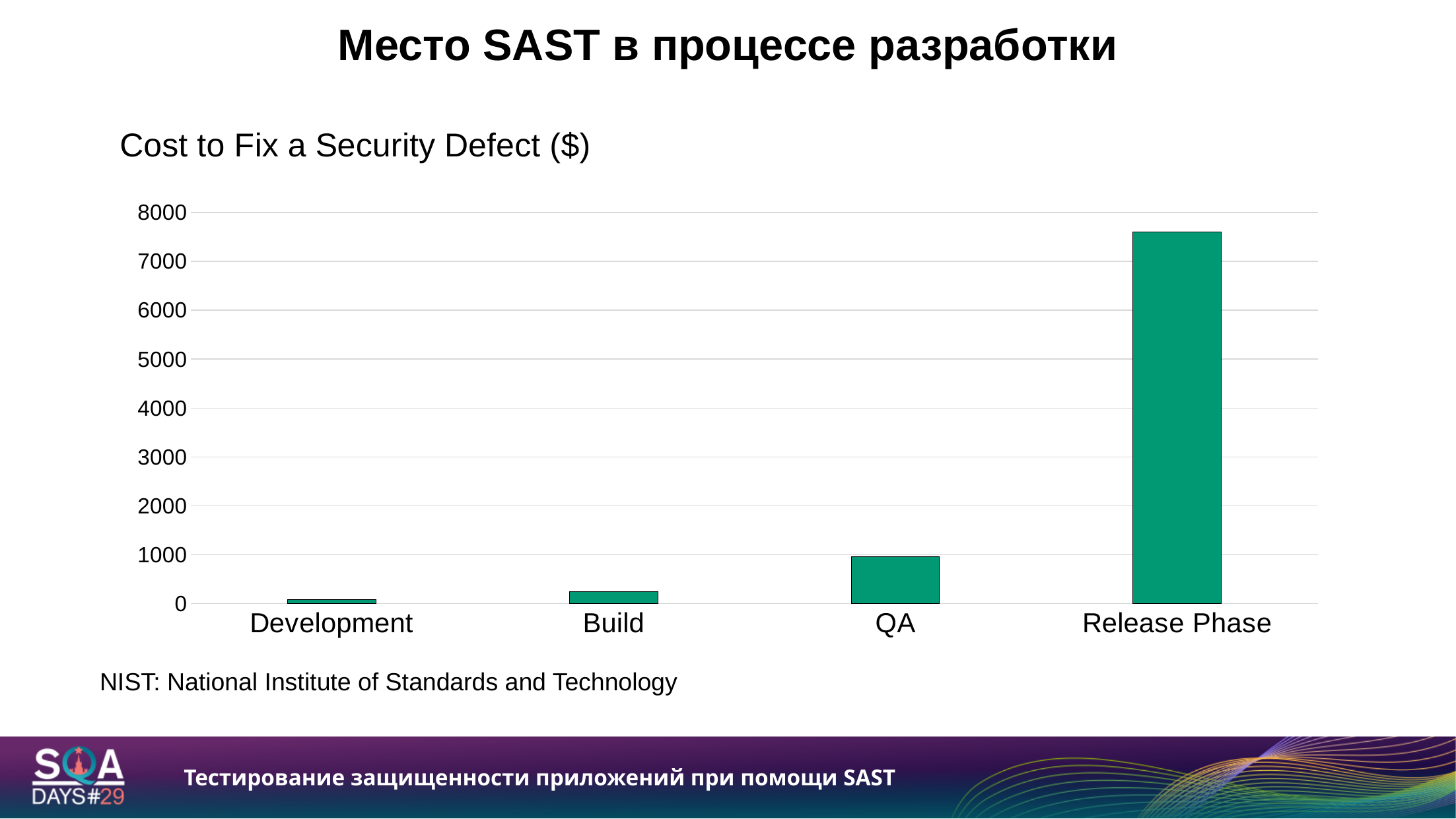
Which category has the lowest cost to fix a security defect? Development How many categories are shown on the x axis of the chart? 4 Is the value for Release Phase greater or less than 7000? greater What is the title of the chart? Cost to Fix a Security Defect ($) Which category has the highest cost to fix a security defect? Release Phase Is the value for Build greater or less than 1000? less What kind of chart is shown on the slide? bar chart Do the values rise or fall from Development to Release Phase along the x axis? rise Which is larger, the value for QA or the value for Build? QA What is the highest value shown on the y axis of the chart? 8000 Is the value for Release Phase greater or less than 8000? less